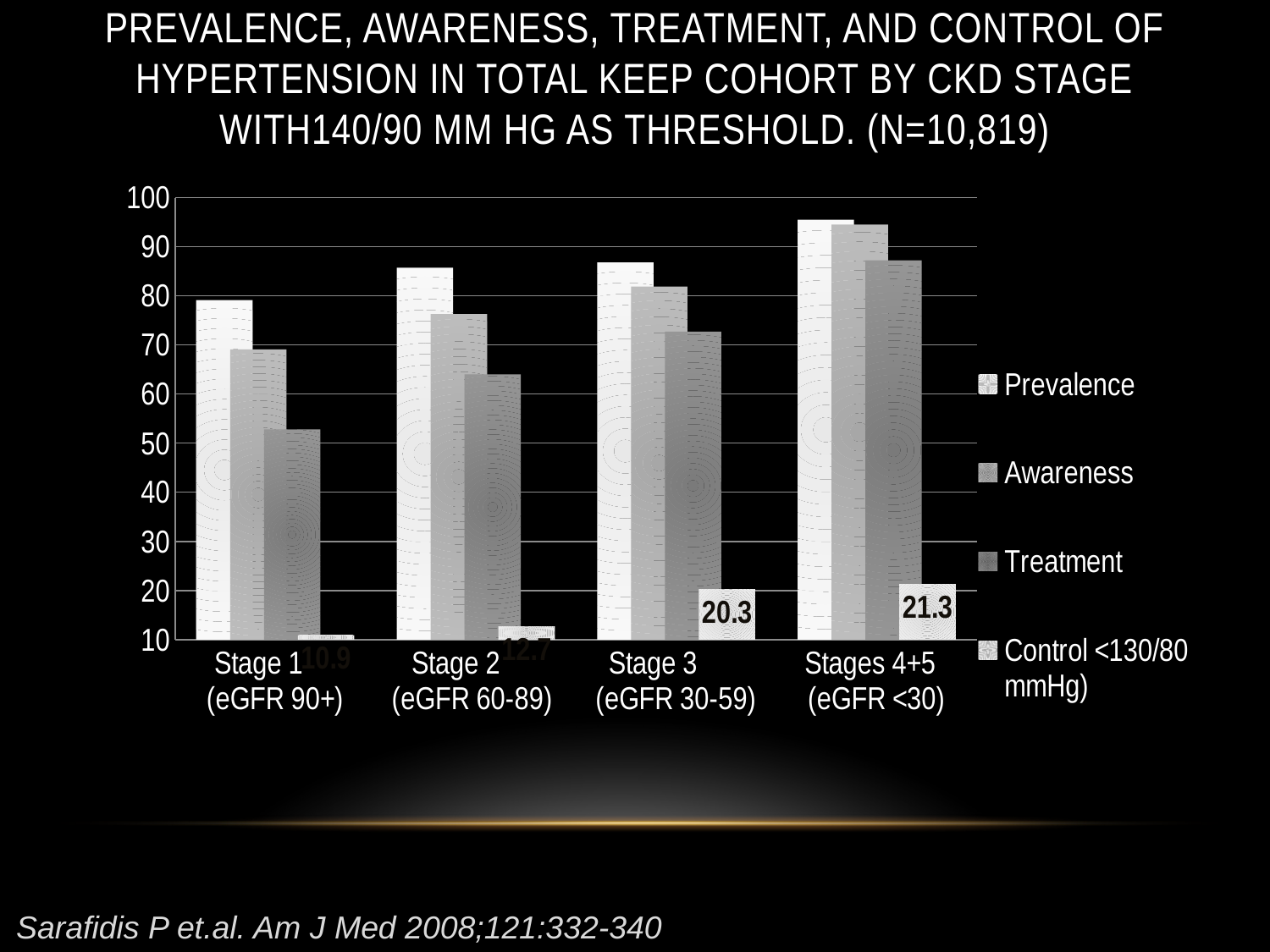
Is the Prevalence value for Stage 1 (eGFR 90+) greater or less than 70? greater What is the Control <130/80 mmHg value for Stages 4+5 (eGFR <30)? 21.3 What is the Control <130/80 mmHg value for Stage 3 (eGFR 30-59)? 20.3 How many series does the legend list? 4 How many CKD stage categories are shown on the x axis? 4 What is the difference between the Control values for Stages 4+5 and Stage 3? 1.0 Is the Treatment value for Stage 1 (eGFR 90+) greater or less than 60? less What is the Control <130/80 mmHg value for Stage 2 (eGFR 60-89)? 12.7 Which is larger, the Awareness value for Stage 1 or for Stage 3? Stage 3 Which CKD stage has the lowest Control <130/80 mmHg value? Stage 1 (eGFR 90+) Which CKD stage has the highest Control <130/80 mmHg value? Stages 4+5 (eGFR <30) Does the Prevalence value rise or fall from Stage 1 to Stages 4+5? rise